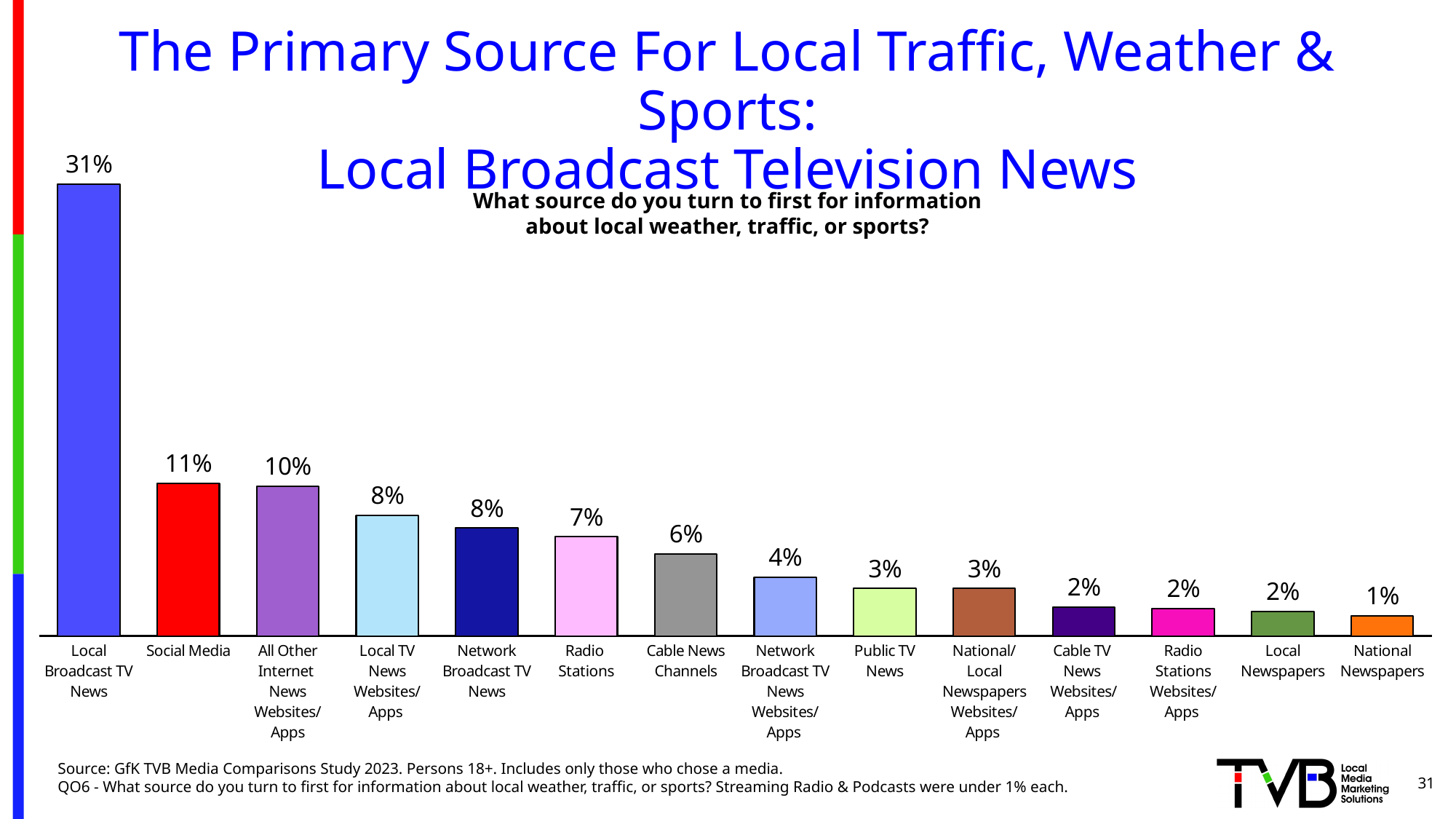
Which category has the highest value? Local Broadcast TV News Do the values rise or fall from left to right along the x axis? Fall What is the value for Social Media? 11% How many categories are shown in the chart? 14 What is the value for Cable News Channels? 6% What is the difference between Local Broadcast TV News and Social Media? 20% What is the value for Local Broadcast TV News? 31% What kind of chart is shown on the slide? Bar chart Which is larger, Radio Stations or Public TV News? Radio Stations Which category has the lowest value? National Newspapers What is the value for National Newspapers? 1% What question is shown as the chart's subtitle? What source do you turn to first for information about local weather, traffic, or sports?